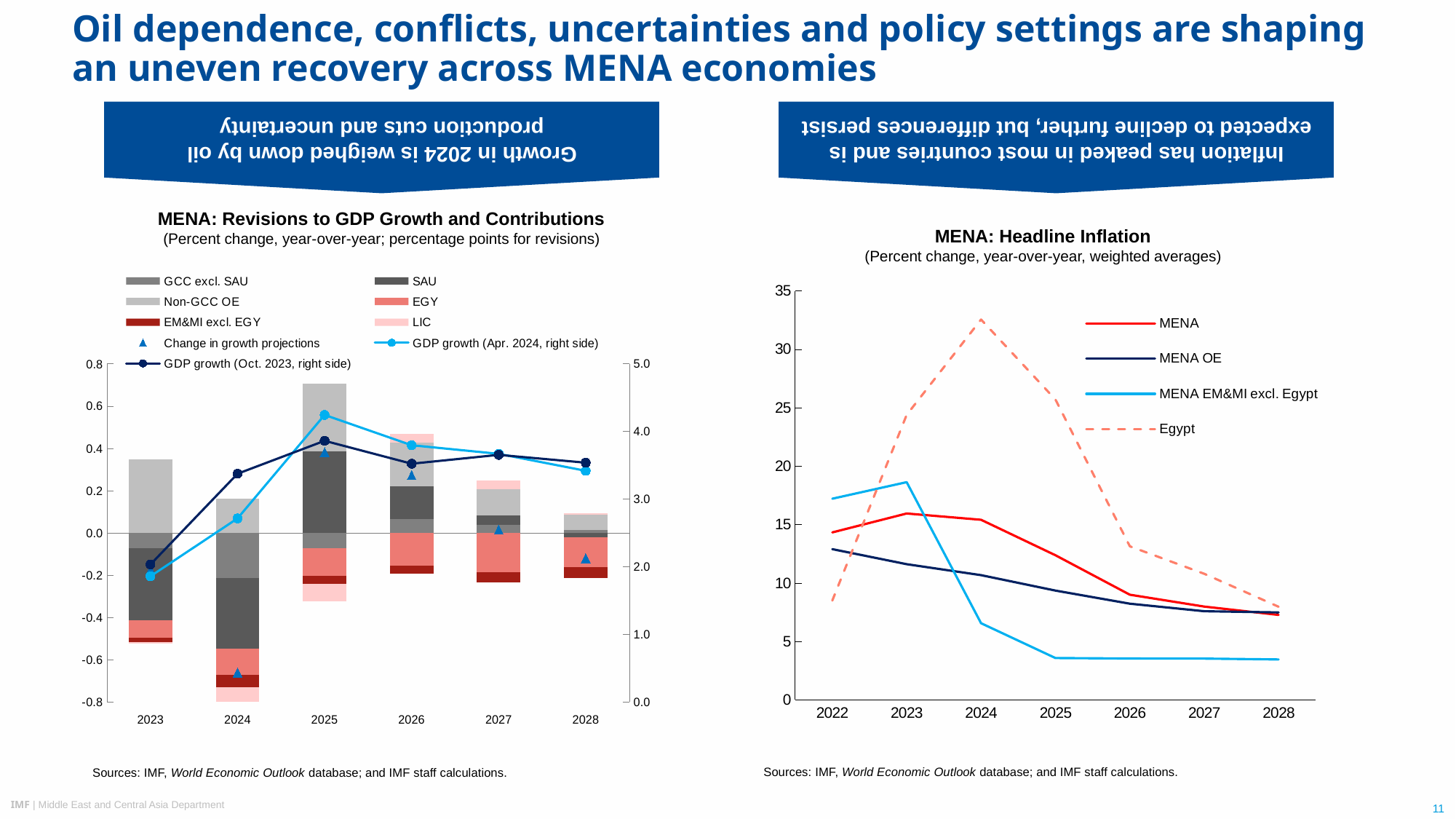
In the 'MENA: Headline Inflation' chart, does the MENA OE series rise or fall from 2022 to 2028? fall How many series does the legend of the 'MENA: Headline Inflation' chart list? 4 In the 'MENA: Revisions to GDP Growth and Contributions' chart, which line is higher in 2024: 'GDP growth (Oct. 2023, right side)' or 'GDP growth (Apr. 2024, right side)'? GDP growth (Oct. 2023, right side) In the 'MENA: Headline Inflation' chart, is the value for MENA EM&MI excl. Egypt in 2026 greater or less than 5? less How many years are shown on the x axis of the 'MENA: Revisions to GDP Growth and Contributions' chart? 6 In the 'MENA: Revisions to GDP Growth and Contributions' chart, in which year does the 'GDP growth (Apr. 2024, right side)' line reach its highest value? 2025 In the 'MENA: Headline Inflation' chart, which series is higher in 2023: MENA or MENA OE? MENA In the 'MENA: Headline Inflation' chart, which series has the lowest value in 2025? MENA EM&MI excl. Egypt In the 'MENA: Headline Inflation' chart, is the value for Egypt in 2024 greater or less than 30? greater In the 'MENA: Headline Inflation' chart, which series has the highest value in 2024? Egypt How many years are shown on the x axis of the 'MENA: Headline Inflation' chart? 7 What kind of chart is the 'MENA: Headline Inflation' chart? line chart